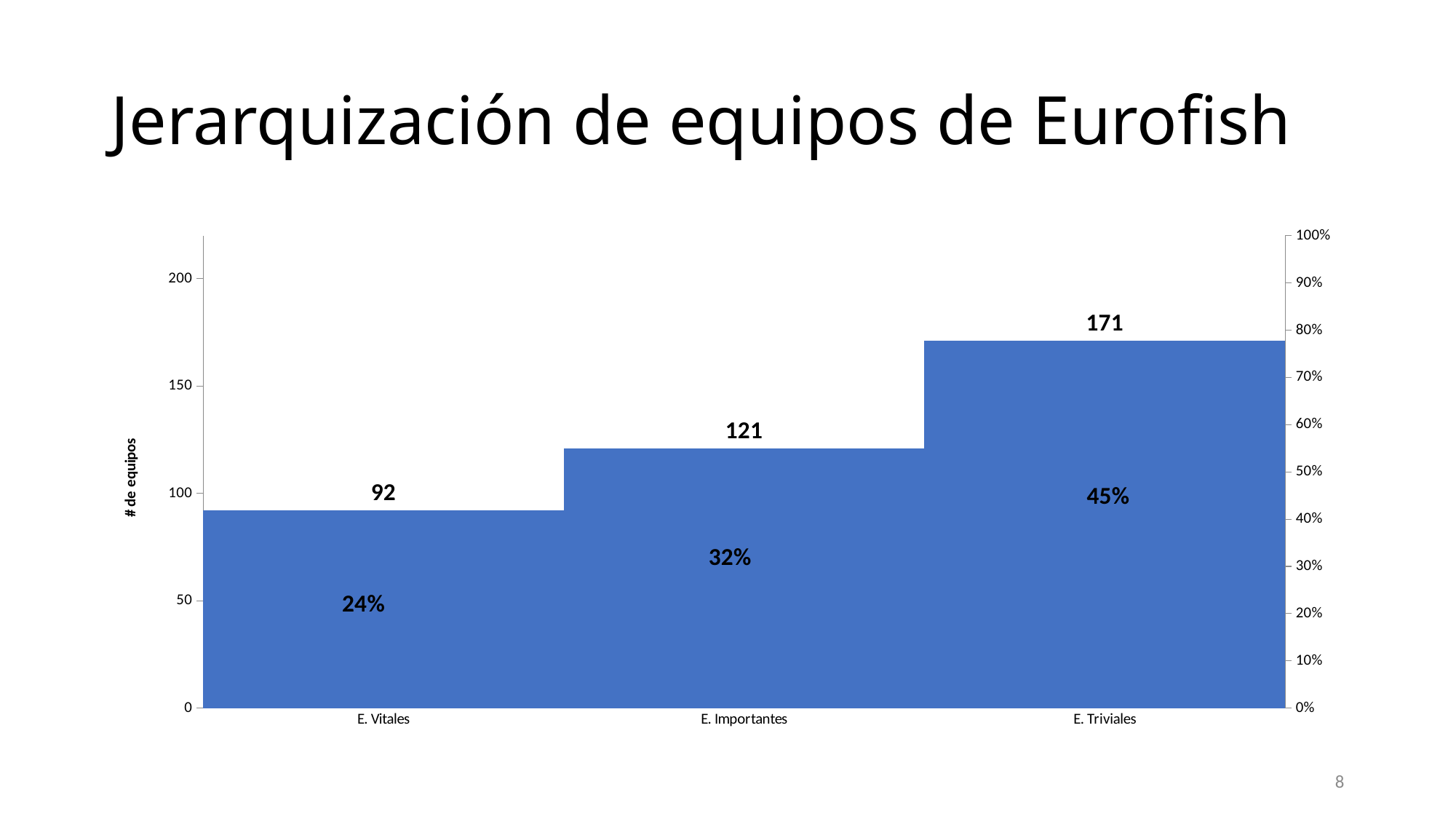
How many equipos are shown for E. Vitales? 92 Which category has the lowest number of equipos? E. Vitales What is the number of equipos for E. Triviales? 171 How many categories are shown on the x axis? 3 What percentage is shown for E. Triviales? 45% What is the number of equipos for E. Importantes? 121 What is the label of the left vertical axis? # de equipos What percentage is shown for E. Vitales? 24% Which has more equipos, E. Importantes or E. Vitales? E. Importantes What kind of chart is shown on the slide? Bar chart What is the difference in number of equipos between E. Triviales and E. Vitales? 79 Which category has the highest number of equipos? E. Triviales